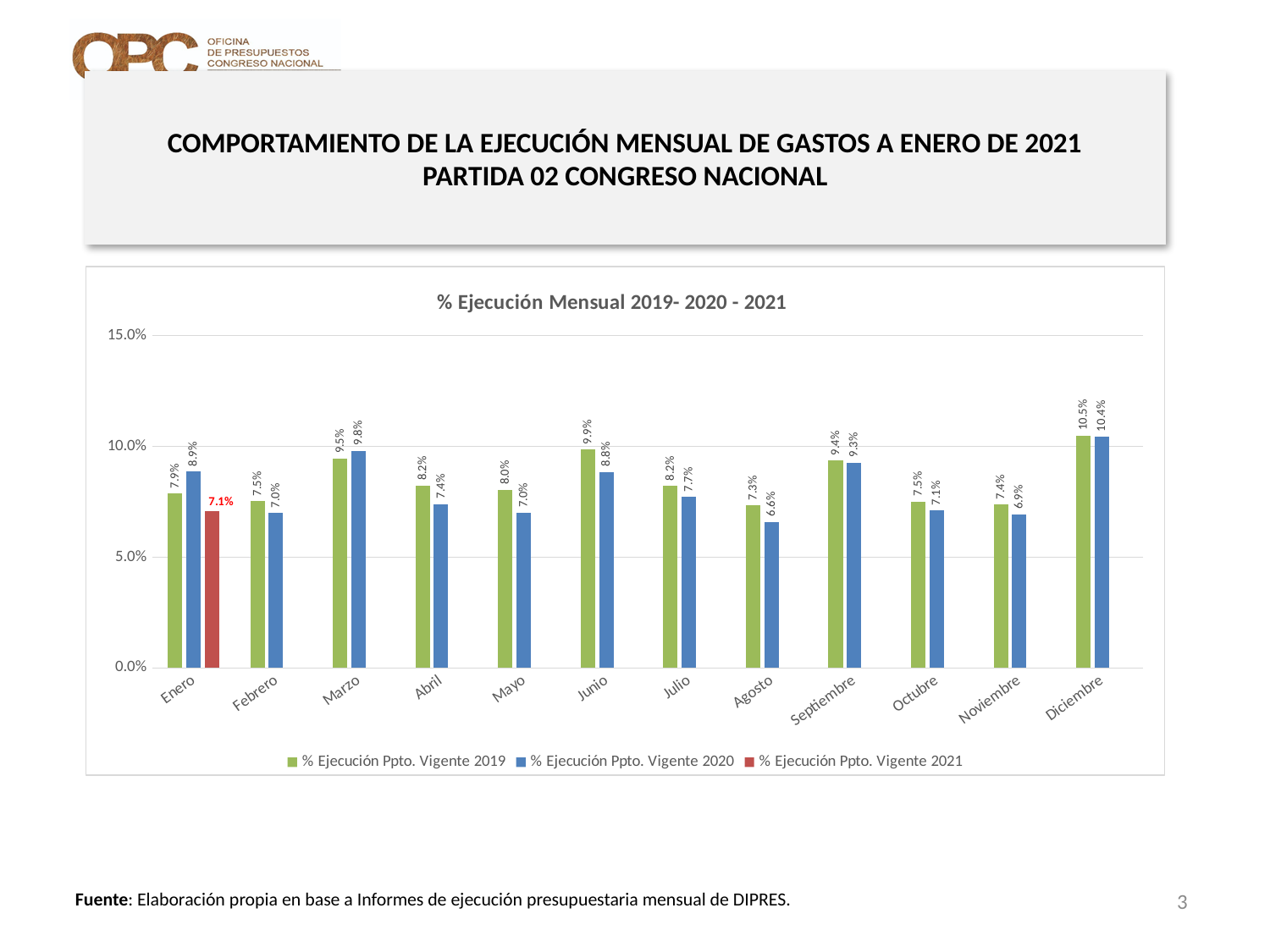
What is the title of the chart? % Ejecución Mensual 2019- 2020 - 2021 Which month has the highest value for % Ejecución Ppto. Vigente 2019? Diciembre What is the value for % Ejecución Ppto. Vigente 2019 in Junio? 9.9% In Marzo, which series has the larger value, 2019 or 2020? % Ejecución Ppto. Vigente 2020 What kind of chart is shown on the slide? Bar chart Is the value for % Ejecución Ppto. Vigente 2019 in Diciembre greater or less than 10.0%? greater What is the value for % Ejecución Ppto. Vigente 2020 in Agosto? 6.6% Which month has the lowest value for % Ejecución Ppto. Vigente 2020? Agosto What is the difference between the 2020 and 2019 values in Enero? 1.0% What is the value for % Ejecución Ppto. Vigente 2021 in Enero? 7.1% How many months are shown on the x axis? 12 How many series does the legend list? 3